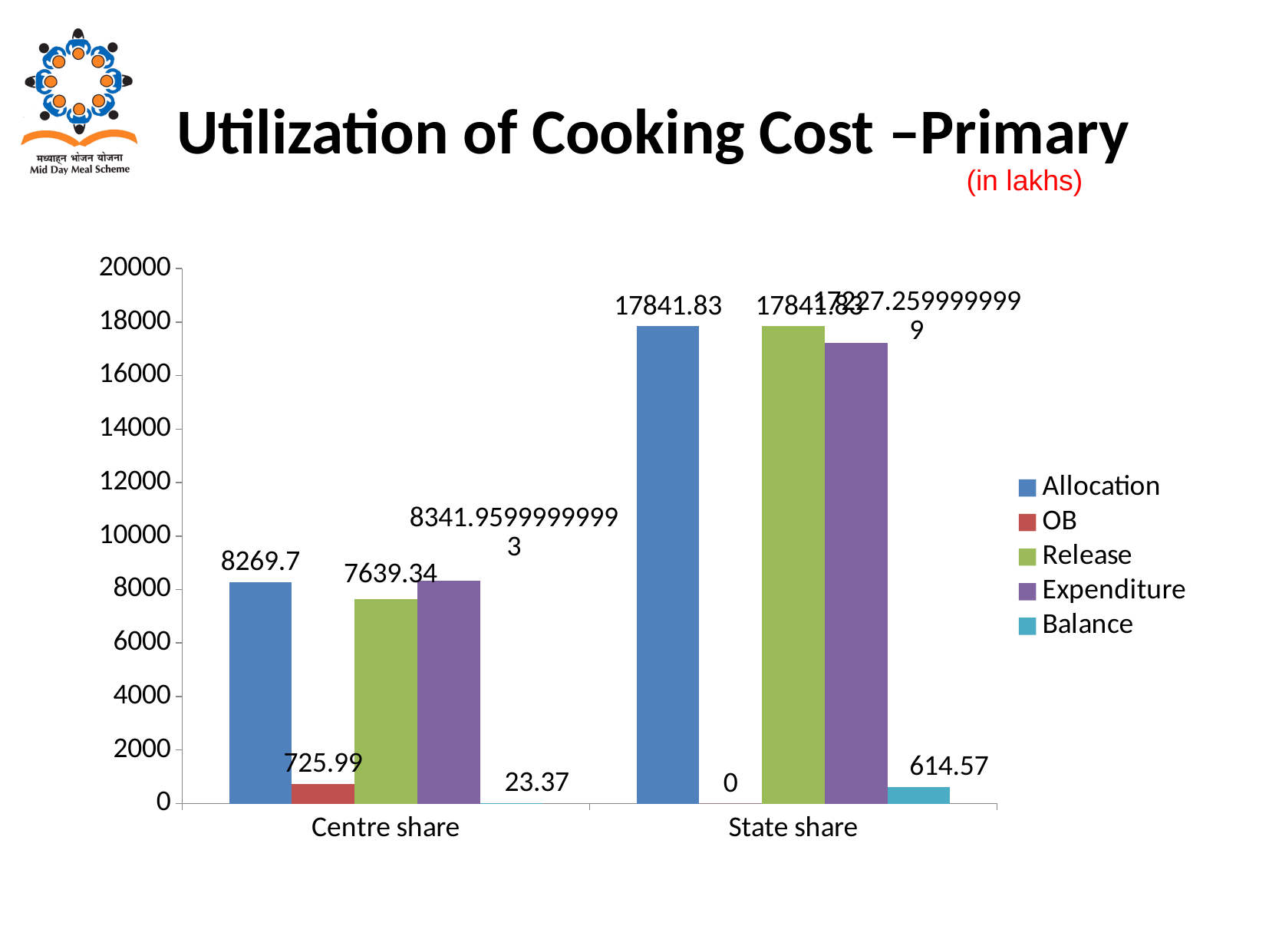
What is the OB value for State share? 0 What is the Allocation value for State share? 17841.83 How many series does the legend list? 5 What is the Allocation value for Centre share? 8269.7 What is the difference between the Allocation and Release values for Centre share? 630.36 Which has the larger Allocation value, Centre share or State share? State share What is the Release value for Centre share? 7639.34 What is the Balance value for State share? 614.57 What is the Balance value for Centre share? 23.37 What kind of chart is shown on the slide? bar chart How many categories are shown on the x axis? 2 What is the OB value for Centre share? 725.99